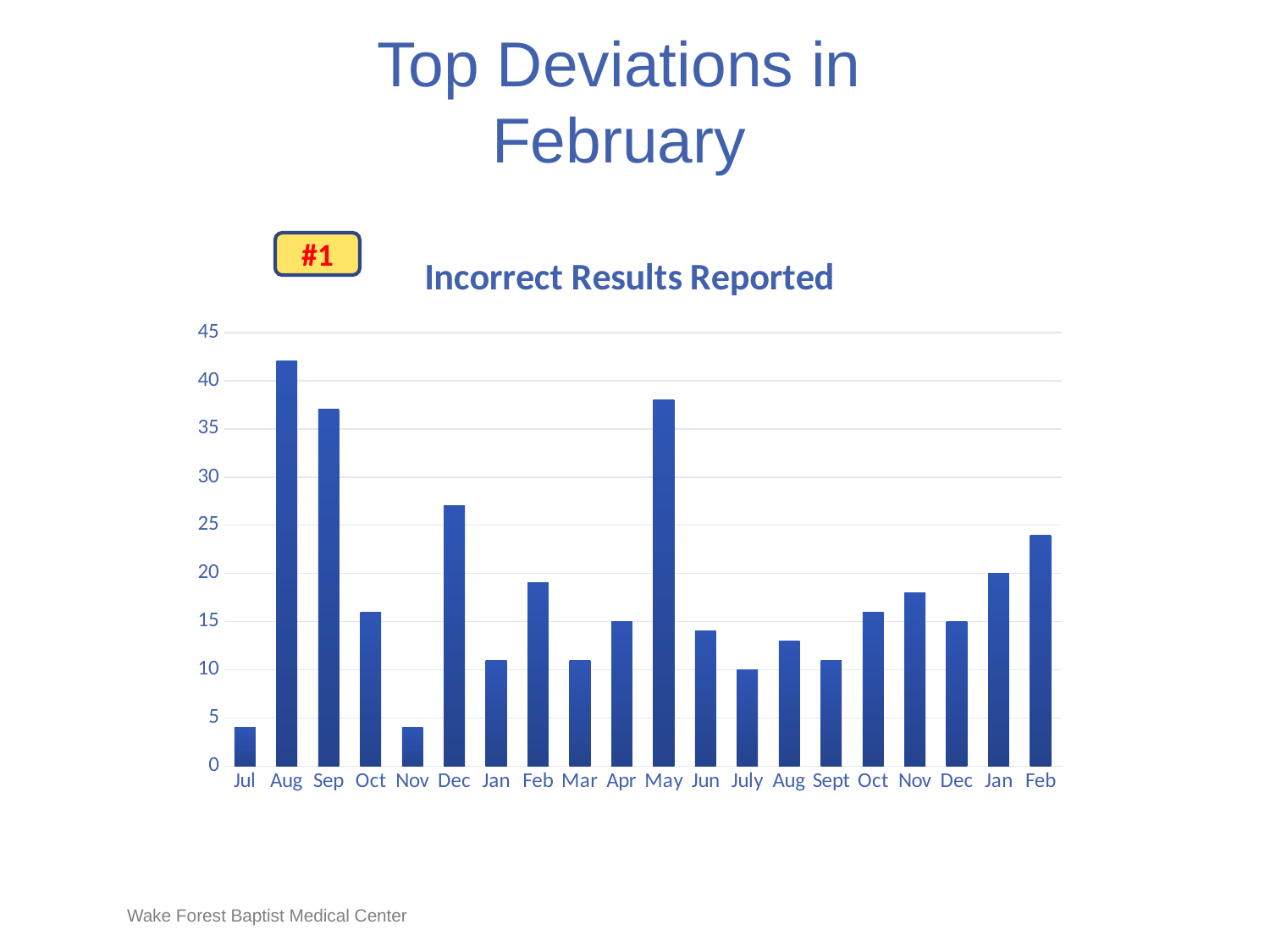
How many bars (months) are plotted in the chart? 20 What is the title of the chart? Incorrect Results Reported Is the value for the last bar, Feb, greater or less than 25? less Is the value for the first Dec bar greater or less than 25? greater Which is larger, the value for the first Aug bar or the value for May? Aug What number appears in the yellow box next to the chart title? #1 Is the value for Jul (the first bar) greater or less than 5? less Which is larger, the value for the first Feb bar or the value for the last Feb bar? the last Feb Which month has the highest value in the chart? Aug (the first Aug) What kind of chart is shown on the slide? bar chart